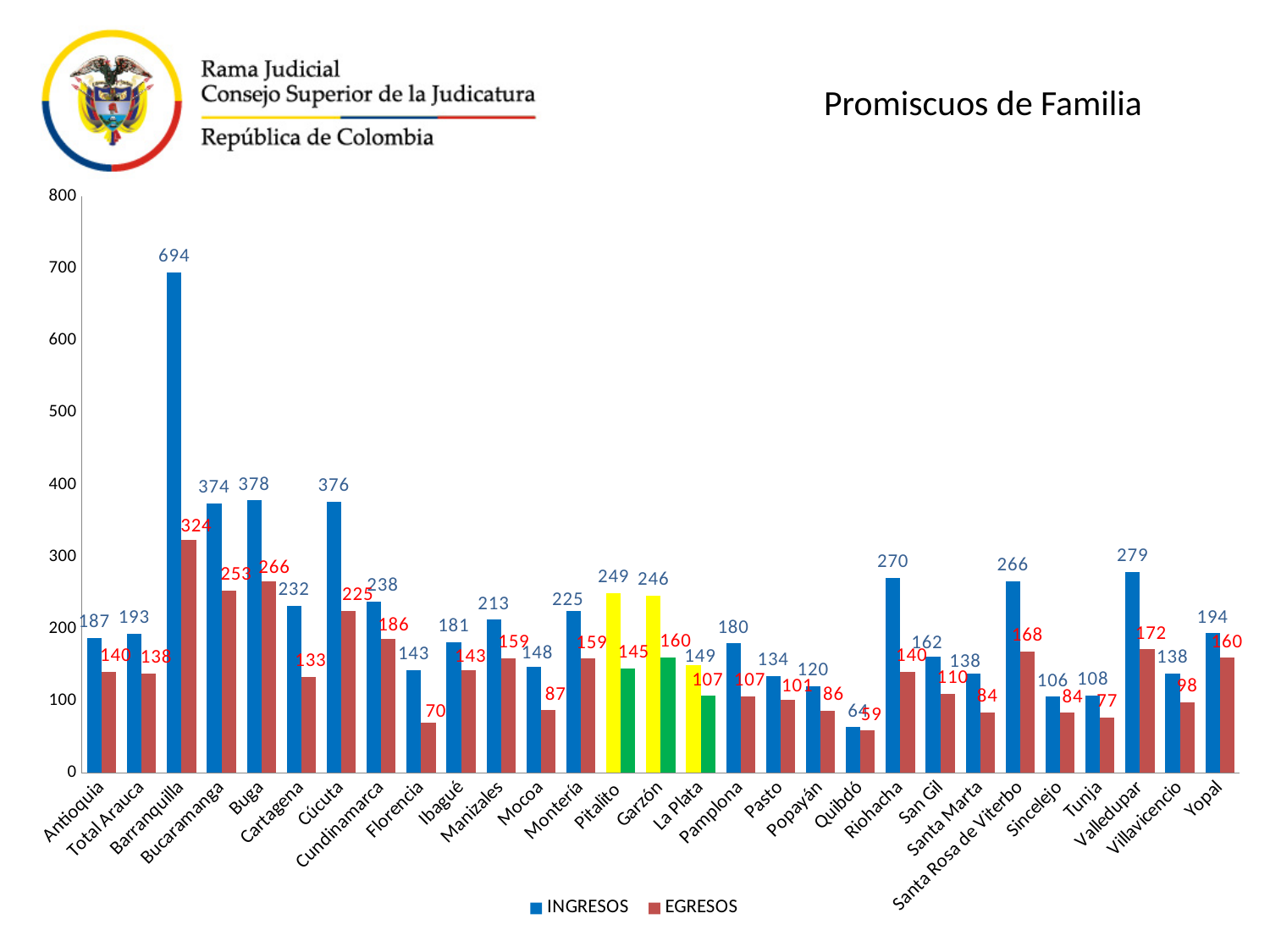
Is the EGRESOS value for Bucaramanga greater or less than 200? greater What is the difference between INGRESOS and EGRESOS for Valledupar? 107 What is the EGRESOS value for Cúcuta? 225 What kind of chart is shown on the slide? Bar chart What is the INGRESOS value for Riohacha? 270 What is the title shown above the chart? Promiscuos de Familia How many categories are shown on the x axis? 29 How many series does the legend list? 2 Which category has the highest INGRESOS value? Barranquilla Which is larger, the INGRESOS value for Pitalito or the INGRESOS value for Garzón? Pitalito What is the INGRESOS value for Barranquilla? 694 Which category has the lowest EGRESOS value? Quibdó